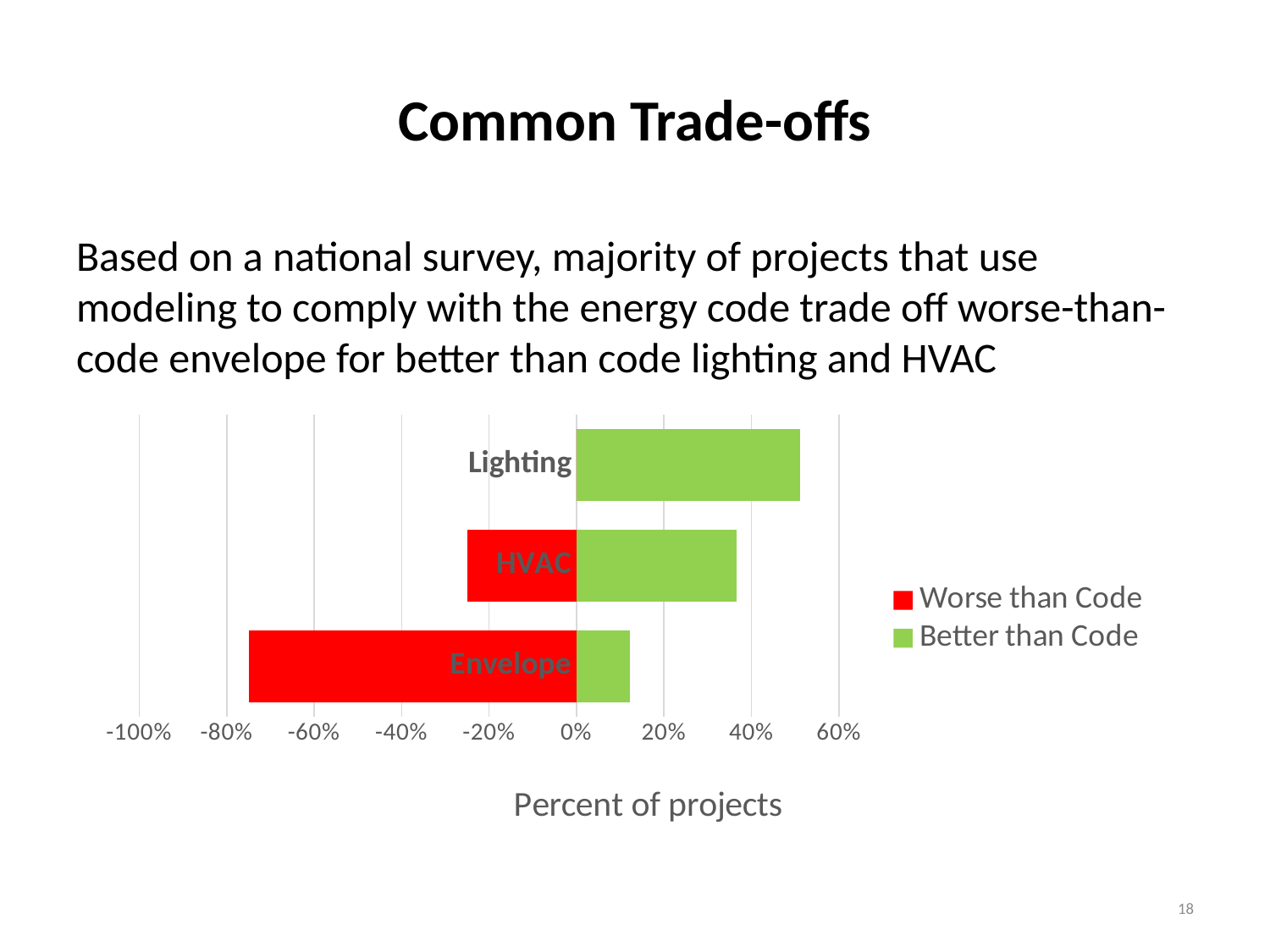
Is the Better than Code value for Envelope greater or less than 20%? less What is the title of the horizontal axis? Percent of projects How many series does the chart legend list? 2 What kind of chart is shown on the slide? bar chart Is the Better than Code value for Lighting greater or less than 40%? greater Which category has the highest Better than Code value? Lighting Which is larger, the Better than Code value for Lighting or for HVAC? Lighting What colour represents the Worse than Code series? red How many categories are plotted in the chart? 3 Which category has the lowest Better than Code value? Envelope Which category has the largest Worse than Code bar? Envelope Is the Better than Code value for HVAC greater or less than 20%? greater